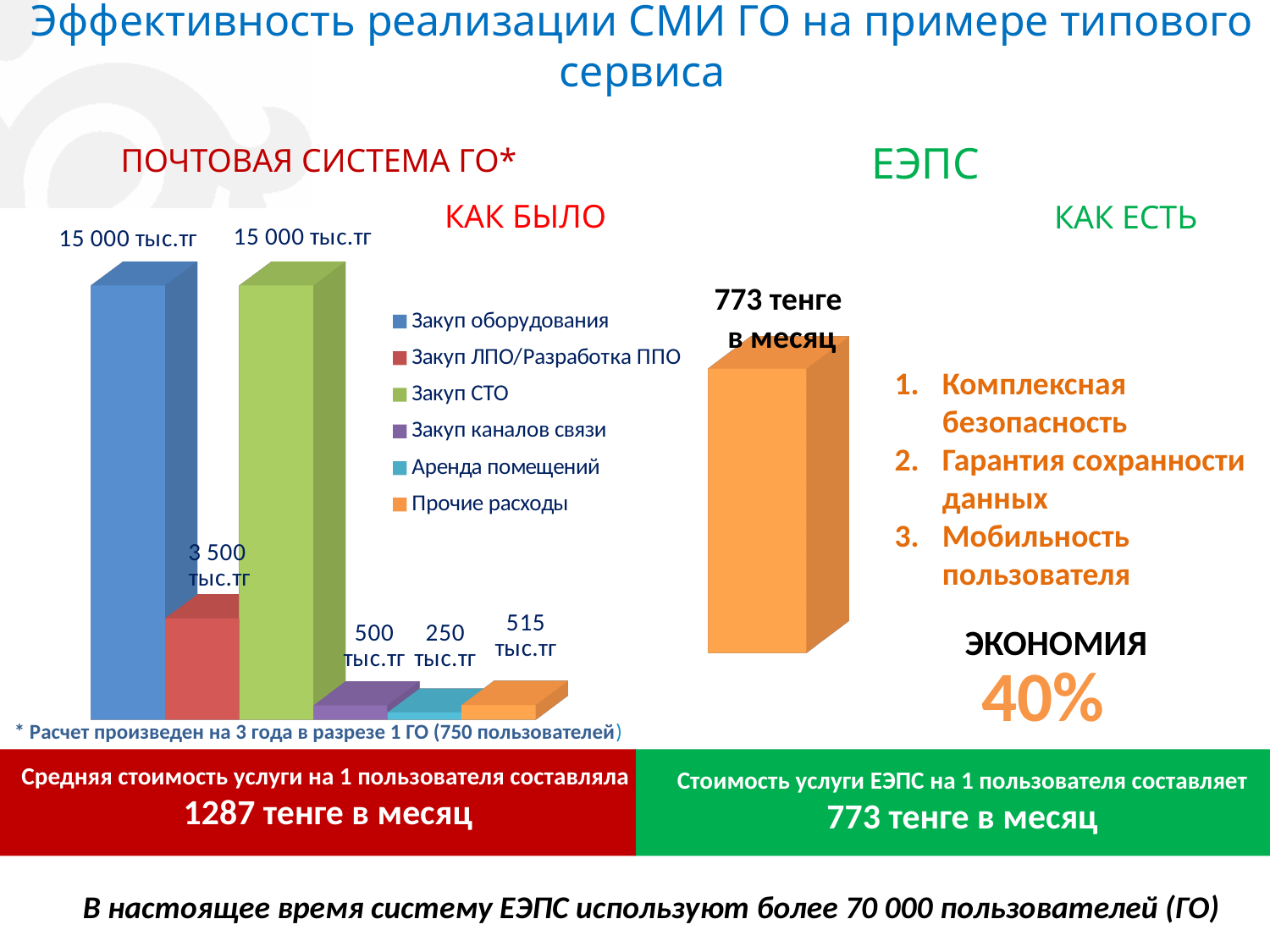
On the left chart (ПОЧТОВАЯ СИСТЕМА ГО), which category has the lowest value? Аренда помещений On the left chart (ПОЧТОВАЯ СИСТЕМА ГО), what is the value for Закуп ЛПО/Разработка ППО? 3 500 тыс.тг On the left chart (ПОЧТОВАЯ СИСТЕМА ГО), how many series does the legend list? 6 On the left chart (ПОЧТОВАЯ СИСТЕМА ГО), what is the value for Прочие расходы? 515 тыс.тг On the left chart (ПОЧТОВАЯ СИСТЕМА ГО), what is the difference between Закуп ЛПО/Разработка ППО and Закуп каналов связи? 3 000 тыс.тг On the left chart (ПОЧТОВАЯ СИСТЕМА ГО), what is the value for Аренда помещений? 250 тыс.тг On the left chart (ПОЧТОВАЯ СИСТЕМА ГО), what colour is the bar for Закуп СТО? Green On the right chart (ЕЭПС), what value is shown for the single bar? 773 тенге в месяц On the left chart (ПОЧТОВАЯ СИСТЕМА ГО), what is the value for Закуп оборудования? 15 000 тыс.тг On the left chart (ПОЧТОВАЯ СИСТЕМА ГО), which is larger: Закуп СТО or Закуп ЛПО/Разработка ППО? Закуп СТО What kind of chart is the left chart (ПОЧТОВАЯ СИСТЕМА ГО)? Bar chart On the left chart (ПОЧТОВАЯ СИСТЕМА ГО), how many bars are plotted? 6